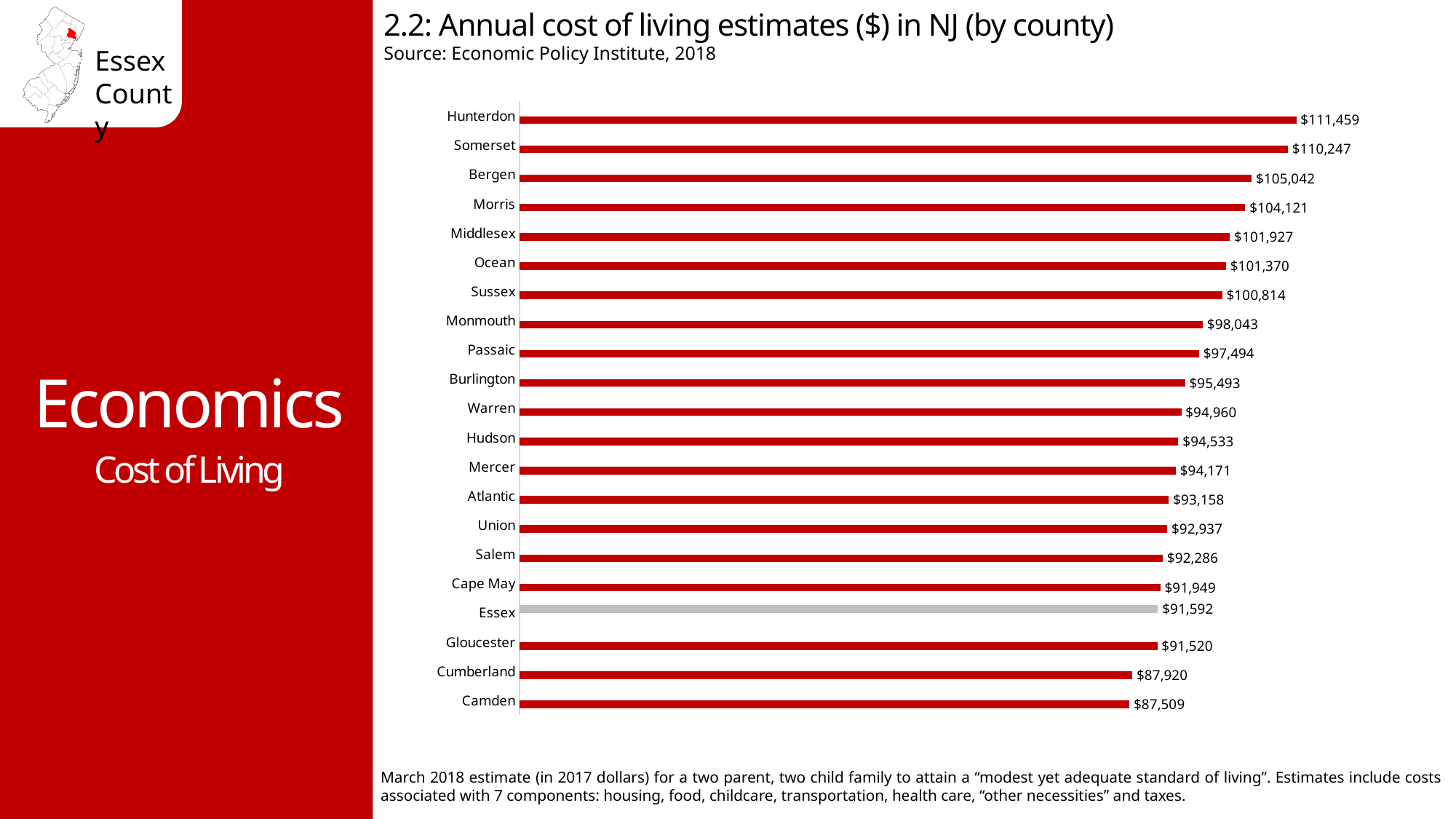
How many counties are shown in the chart? 21 What is the difference between the cost of living estimates for Hunterdon and Camden? $23,950 What is the difference between the cost of living estimates for Essex and Gloucester? $72 What is the annual cost of living estimate for Monmouth County? $98,043 What is the annual cost of living estimate for Bergen County? $105,042 Which county has a higher cost of living estimate, Passaic or Burlington? Passaic Which county has a higher cost of living estimate, Morris or Middlesex? Morris Which county has the lowest annual cost of living estimate? Camden Which county has the highest annual cost of living estimate? Hunterdon What type of chart is used on this slide? Bar chart Which county's bar is shown in grey instead of red? Essex What is the annual cost of living estimate for Essex County? $91,592